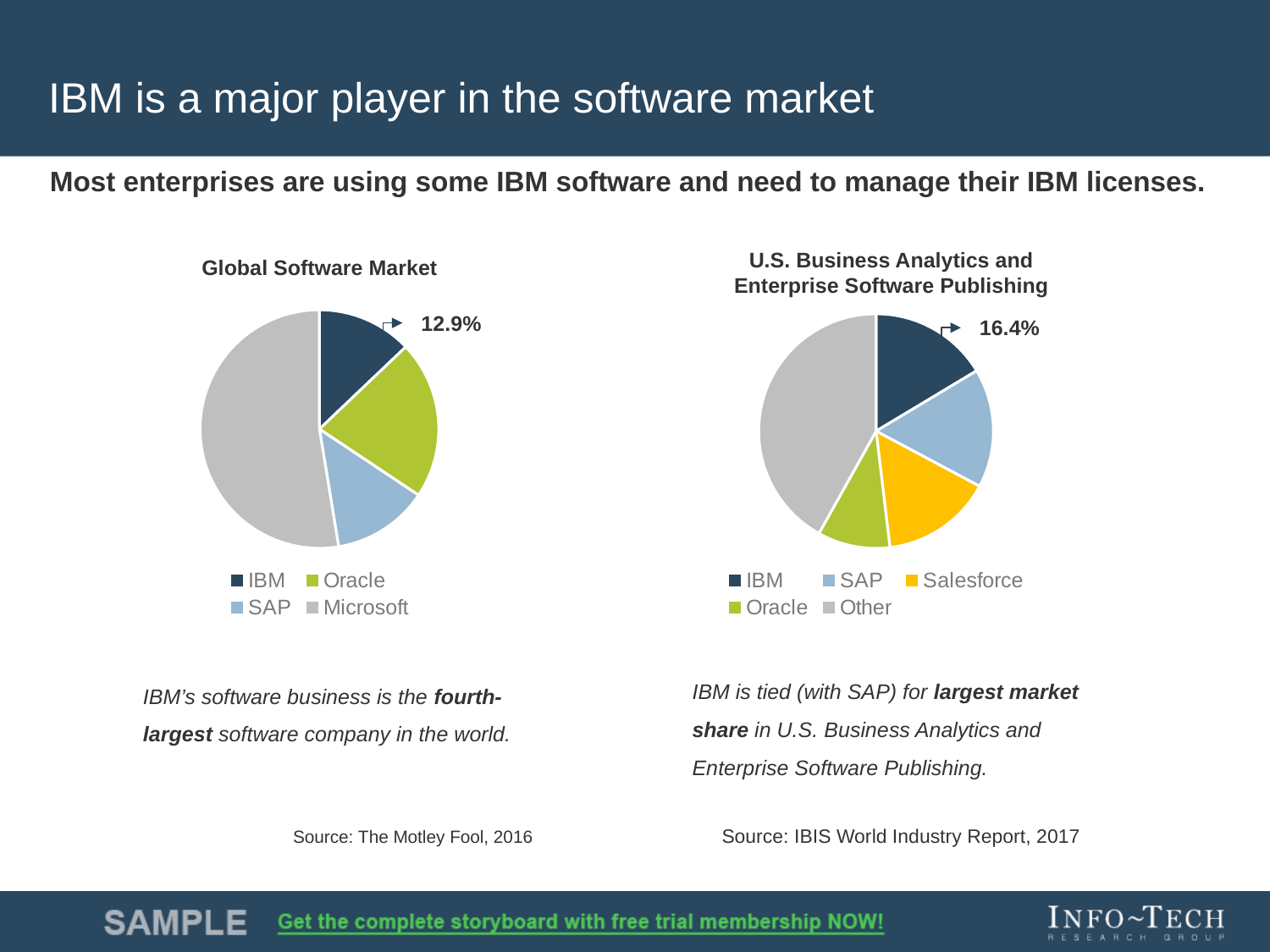
In the U.S. Business Analytics and Enterprise Software Publishing chart, which category has the largest slice? Other In the U.S. Business Analytics and Enterprise Software Publishing chart, what share is labelled for IBM? 16.4% In the U.S. Business Analytics and Enterprise Software Publishing chart, which slice is larger, Other or Salesforce? Other What kind of chart is the Global Software Market chart? pie chart In the Global Software Market chart, which company has the largest slice? Microsoft In the Global Software Market chart, which slice is larger, Oracle or IBM? Oracle How many slices does the Global Software Market pie chart have? 4 In the Global Software Market chart, what share is labelled for IBM? 12.9% What is the title of the pie chart on the left of the slide? Global Software Market How many entries does the legend of the U.S. Business Analytics and Enterprise Software Publishing chart list? 5 How many slices does the U.S. Business Analytics and Enterprise Software Publishing pie chart have? 5 In the Global Software Market chart, which company is shown in dark blue? IBM